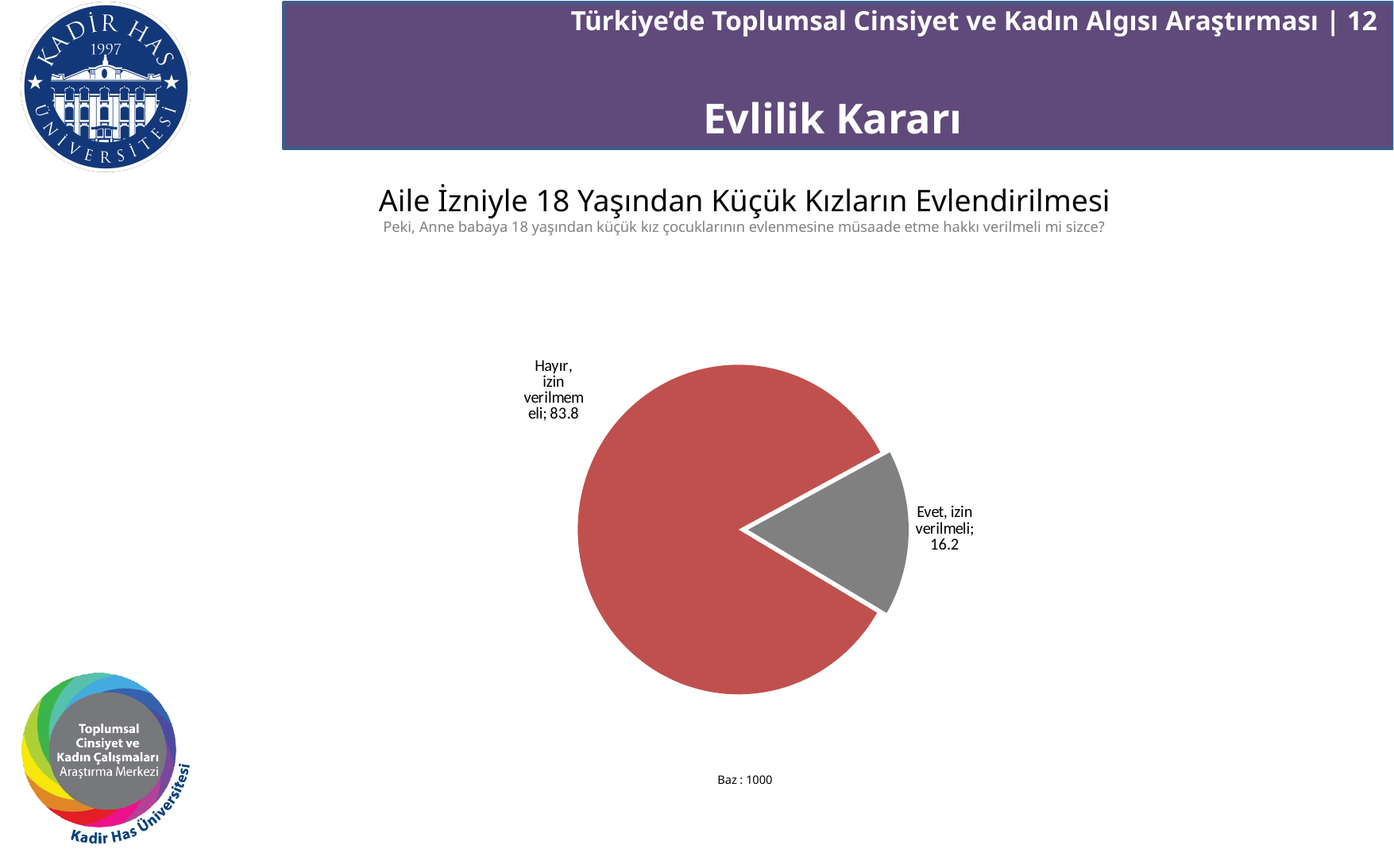
What is the title of the chart on the slide? Aile İzniyle 18 Yaşından Küçük Kızların Evlendirilmesi What is the total of the two slice values shown in the pie chart? 100 Which slice of the pie chart is the smallest? Evet, izin verilmeli What base (Baz) sample size is stated below the pie chart? 1000 How many slices does the pie chart have? 2 Which slice of the pie chart is the largest? Hayır, izin verilmemeli Which is larger in the pie chart: 'Evet, izin verilmeli' or 'Hayır, izin verilmemeli'? Hayır, izin verilmemeli What value is shown for the 'Evet, izin verilmeli' slice of the pie chart? 16.2 What value is shown for the 'Hayır, izin verilmemeli' slice of the pie chart? 83.8 What is the difference between the 'Hayır, izin verilmemeli' and 'Evet, izin verilmeli' values in the pie chart? 67.6 What type of chart is shown on the slide? Pie chart